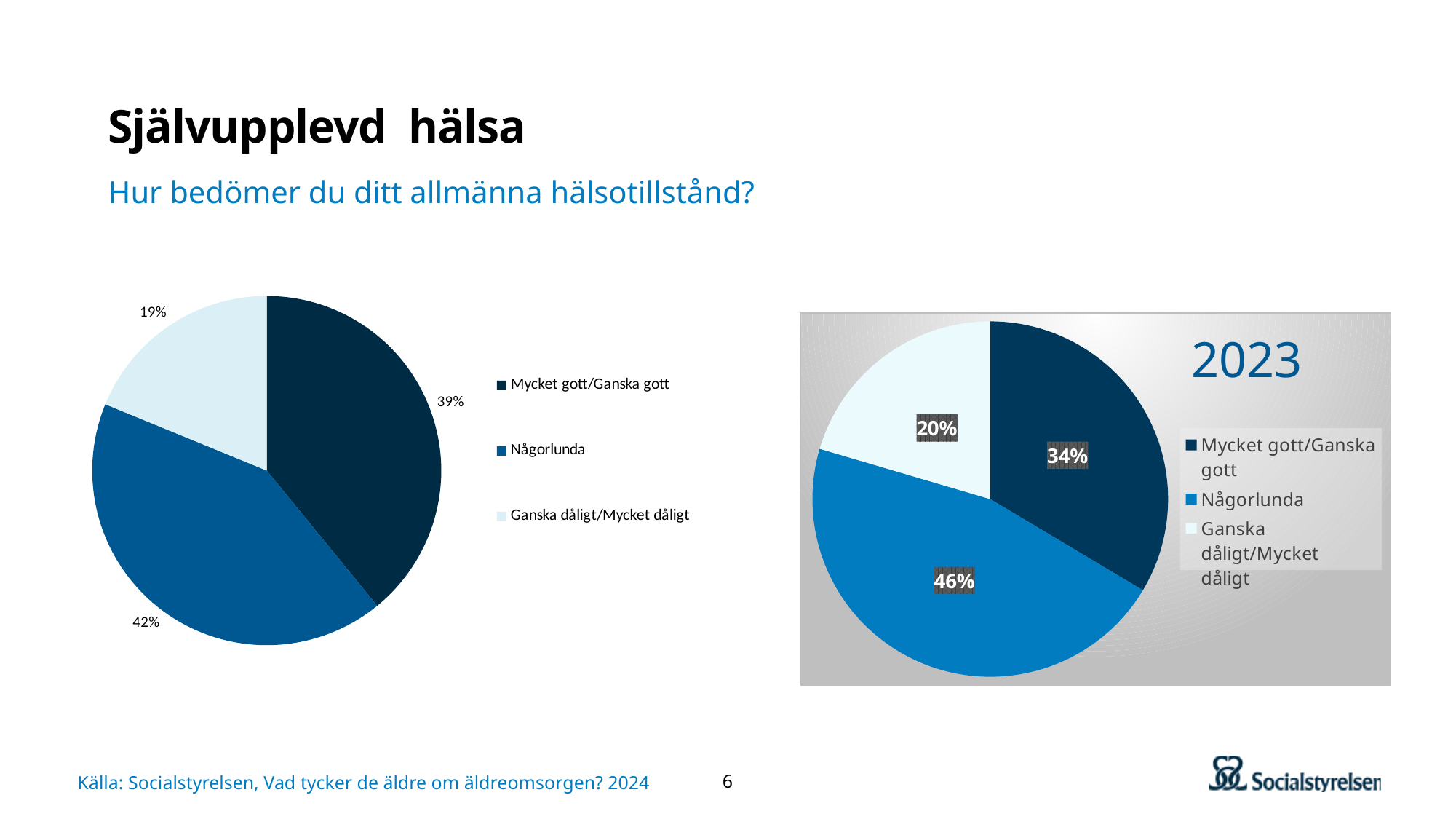
In the 2023 pie chart on the right, what share is labelled for Någorlunda? 46% What type of chart is shown on the right side of the slide? Pie chart In the 2023 pie chart on the right, which category has the smallest slice? Ganska dåligt/Mycket dåligt In the left pie chart, which category has the largest slice? Någorlunda How many slices does the left pie chart have? 3 In the 2023 pie chart on the right, what share is labelled for Mycket gott/Ganska gott? 34% In the 2023 pie chart on the right, what is the difference between the Någorlunda share and the Mycket gott/Ganska gott share? 12 percentage points In the left pie chart, what share is labelled for Någorlunda? 42% In the left pie chart, what share is labelled for Ganska dåligt/Mycket dåligt? 19% In the left pie chart, what share is labelled for Mycket gott/Ganska gott? 39% In the left pie chart, which is larger: the Mycket gott/Ganska gott slice or the Ganska dåligt/Mycket dåligt slice? Mycket gott/Ganska gott What year is shown as the label on the right pie chart? 2023